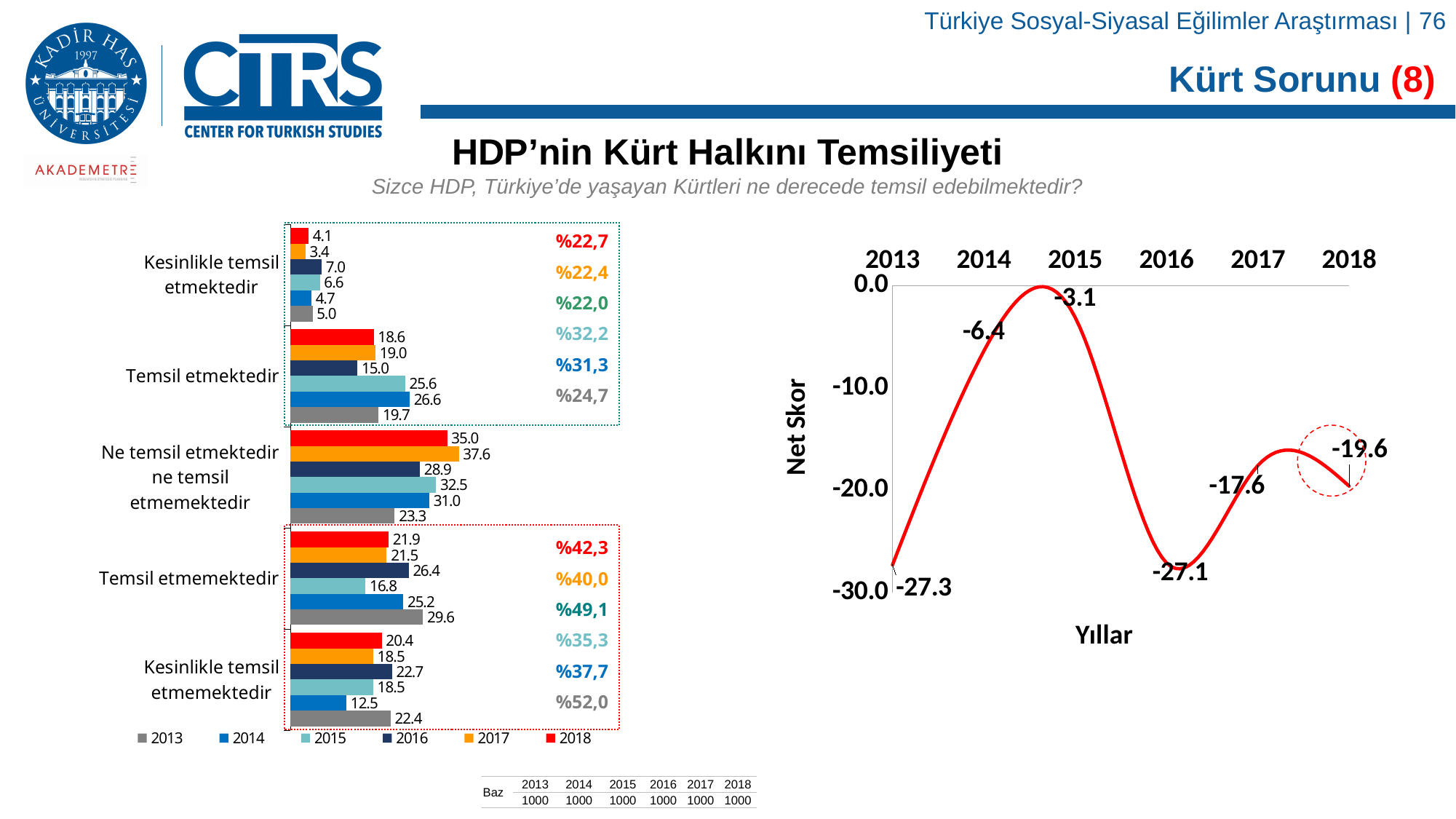
In the bar chart on the left, which year has the highest value for "Kesinlikle temsil etmektedir"? 2016 In the bar chart on the left, what is the 2015 value for "Temsil etmektedir"? 25.6 How many series does the legend of the bar chart on the left list? 6 In the bar chart on the left, which year has the lowest value for "Kesinlikle temsil etmemektedir"? 2014 In the bar chart on the left, which is larger for "Temsil etmektedir": the 2014 value or the 2016 value? 2014 In the bar chart on the left, what is the 2018 value for "Ne temsil etmektedir ne temsil etmemektedir"? 35.0 In the Net Skor line chart on the right, which year has the highest value? 2015 In the bar chart on the left, what is the difference between the 2017 and 2013 values for "Ne temsil etmektedir ne temsil etmemektedir"? 14.3 In the bar chart on the left, what is the 2013 value for "Temsil etmemektedir"? 29.6 In the Net Skor line chart on the right, what is the value for 2016? -27.1 How many categories are shown in the bar chart on the left? 5 What kind of chart is the chart on the right? Line chart